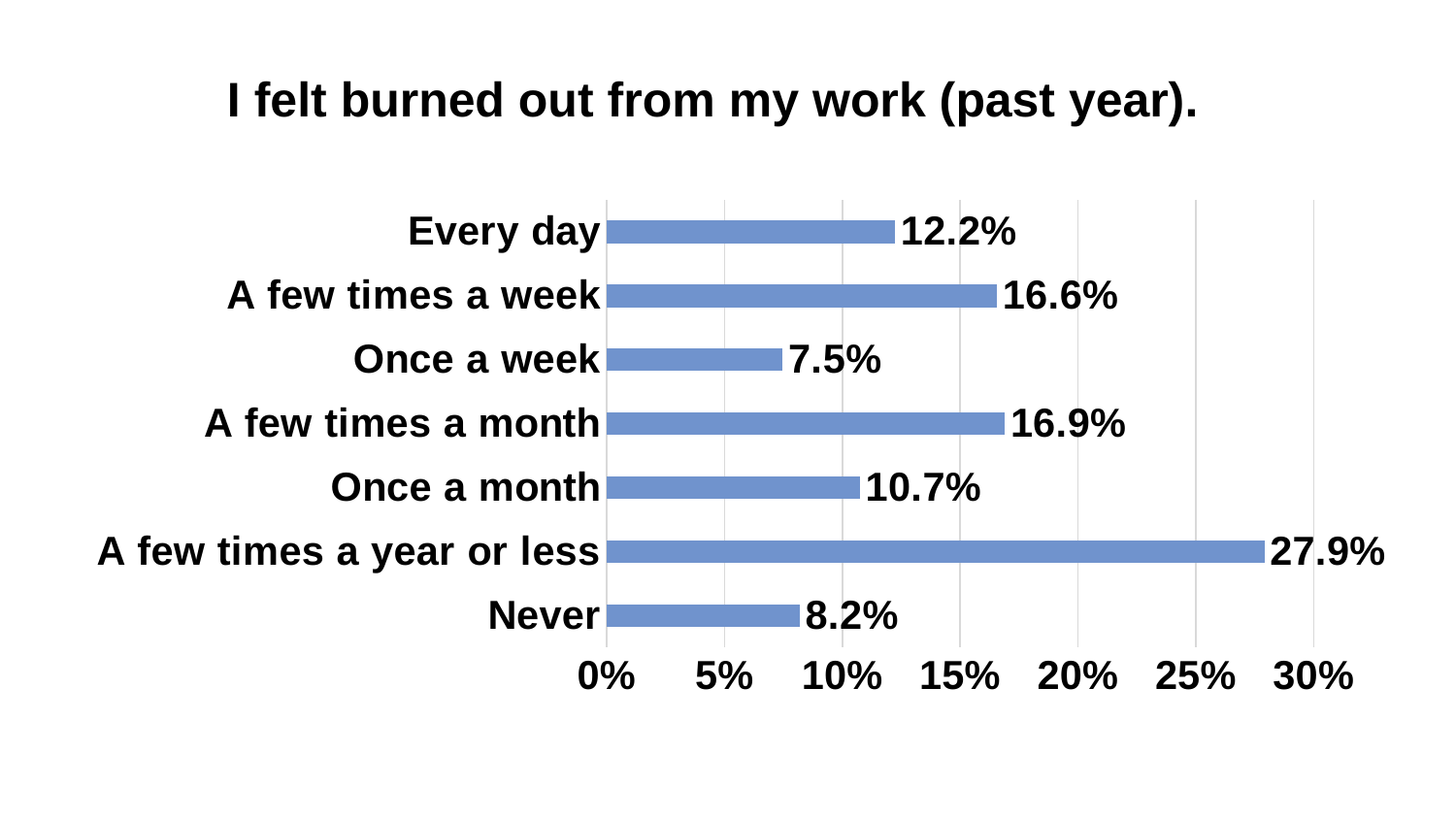
What is the difference between "A few times a year or less" and "Every day"? 15.7% Which category has the lowest value? Once a week Is the value for "A few times a year or less" greater or less than 25%? greater What kind of chart is shown on the slide? Bar chart What is the value for "Every day"? 12.2% Which is larger, the value for "A few times a week" or the value for "Once a week"? A few times a week What is the value for "Once a month"? 10.7% What is the value for "A few times a year or less"? 27.9% What is the difference between "Never" and "Once a week"? 0.7% Which category has the highest value? A few times a year or less What is the title of the chart? I felt burned out from my work (past year). How many categories are shown in the chart? 7